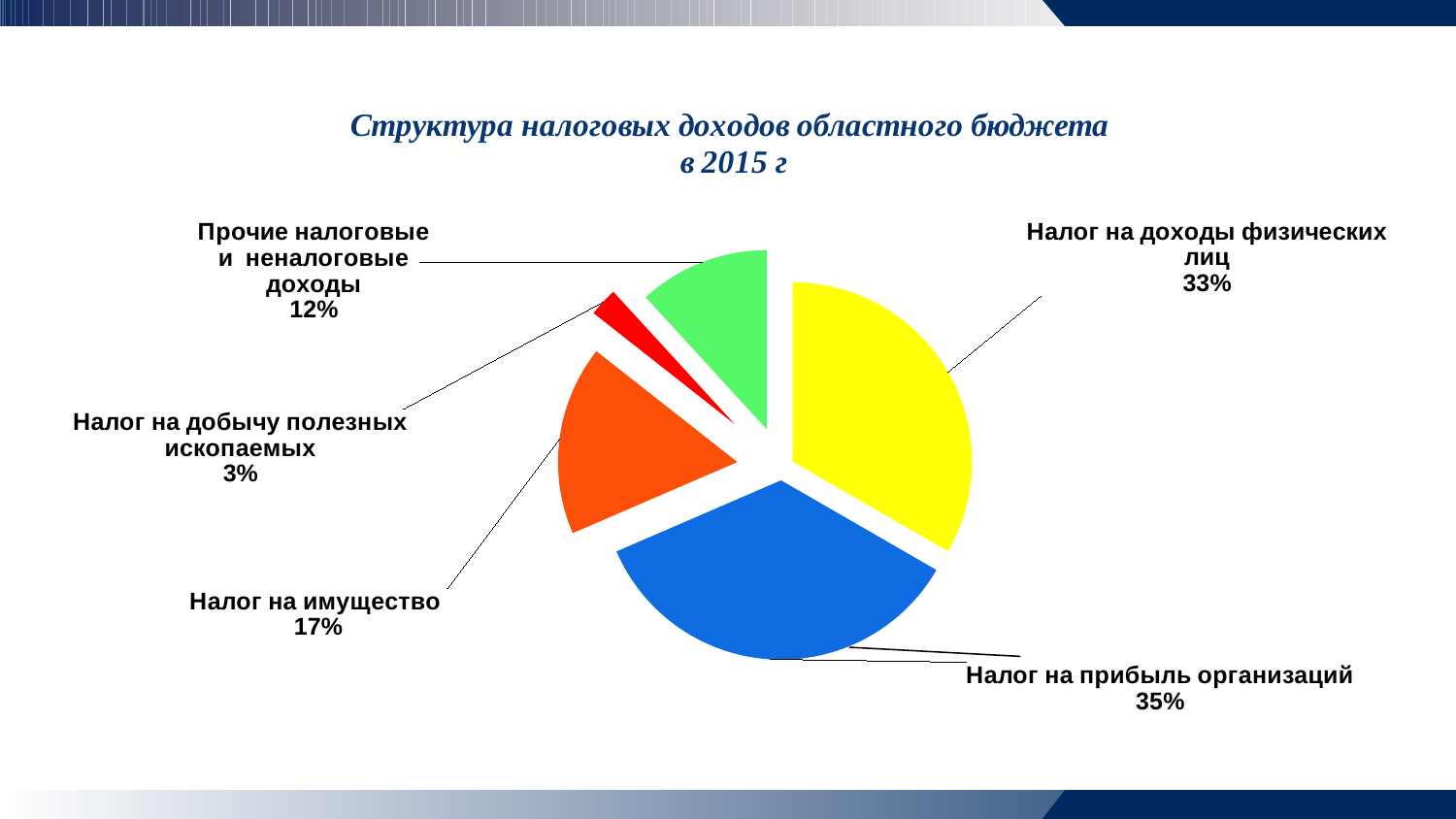
What is the title of the chart? Структура налоговых доходов областного бюджета в 2015 г What kind of chart is shown on the slide? Pie chart Which category has the smallest slice of the pie? Налог на добычу полезных ископаемых What is the value shown for "Налог на добычу полезных ископаемых"? 3% What is the value shown for "Налог на имущество"? 17% What is the difference between the shares of "Налог на прибыль организаций" and "Налог на имущество"? 18% Which is larger: the share of "Налог на имущество" or the share of "Прочие налоговые и неналоговые доходы"? Налог на имущество What is the value shown for "Прочие налоговые и неналоговые доходы"? 12% How many categories are shown in the pie chart? 5 What share of the pie does "Налог на доходы физических лиц" have? 33% What share of the pie does "Налог на прибыль организаций" have? 35% Which category has the largest slice of the pie? Налог на прибыль организаций